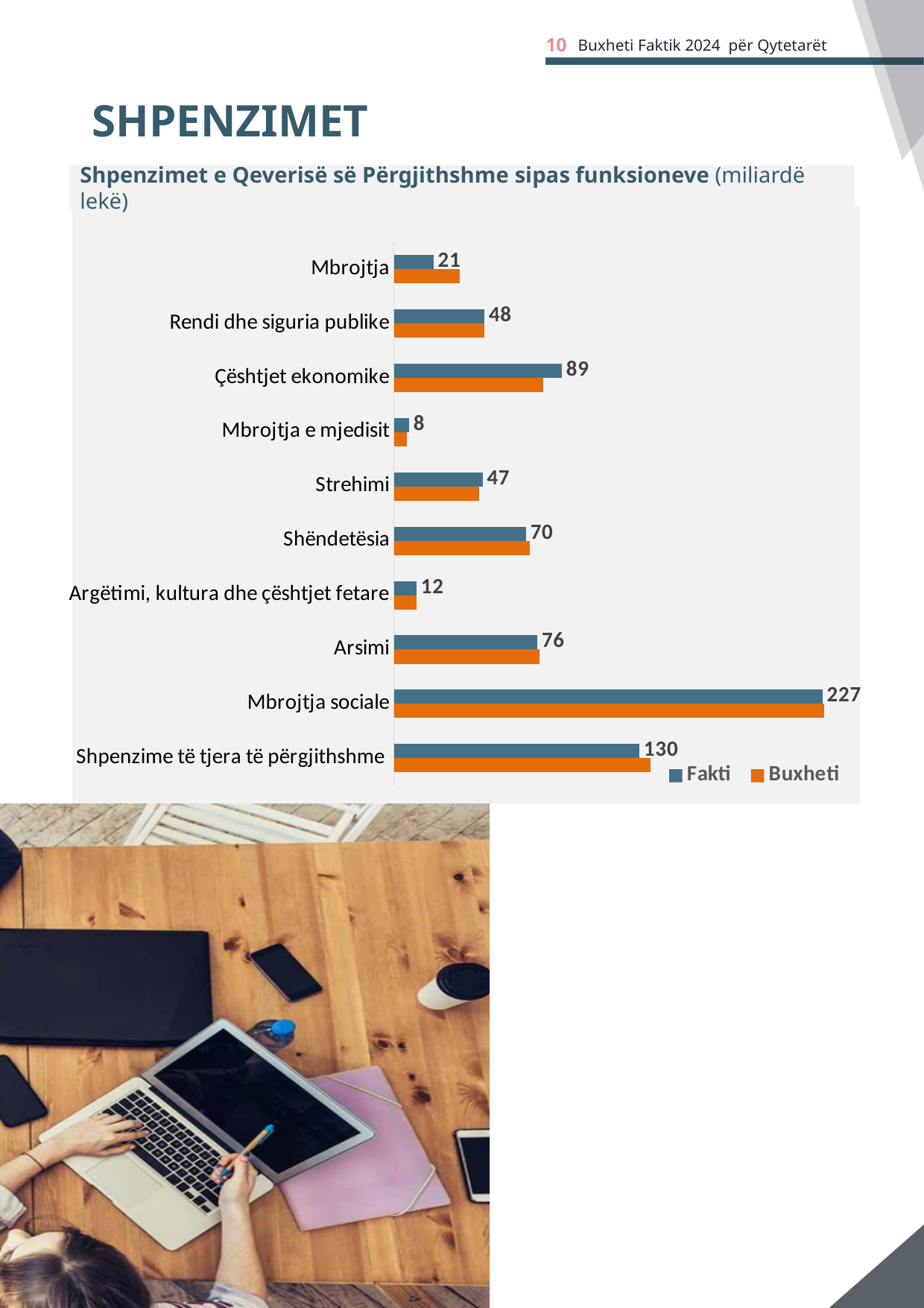
Which is larger for Mbrojtja, the Fakti bar or the Buxheti bar? Buxheti Which is larger for Çështjet ekonomike, the Fakti bar or the Buxheti bar? Fakti What is the Fakti value for Mbrojtja sociale? 227 What kind of chart is shown on the slide? Bar chart How many categories are shown in the chart? 10 Which category has the lowest Fakti value? Mbrojtja e mjedisit What is the Fakti value for Mbrojtja e mjedisit? 8 How many series does the legend list? 2 What is the Fakti value for Shëndetësia? 70 Which category has the highest Fakti value? Mbrojtja sociale What is the difference between the Fakti values for Mbrojtja sociale and Shpenzime të tjera të përgjithshme? 97 What is the Fakti value for Shpenzime të tjera të përgjithshme? 130